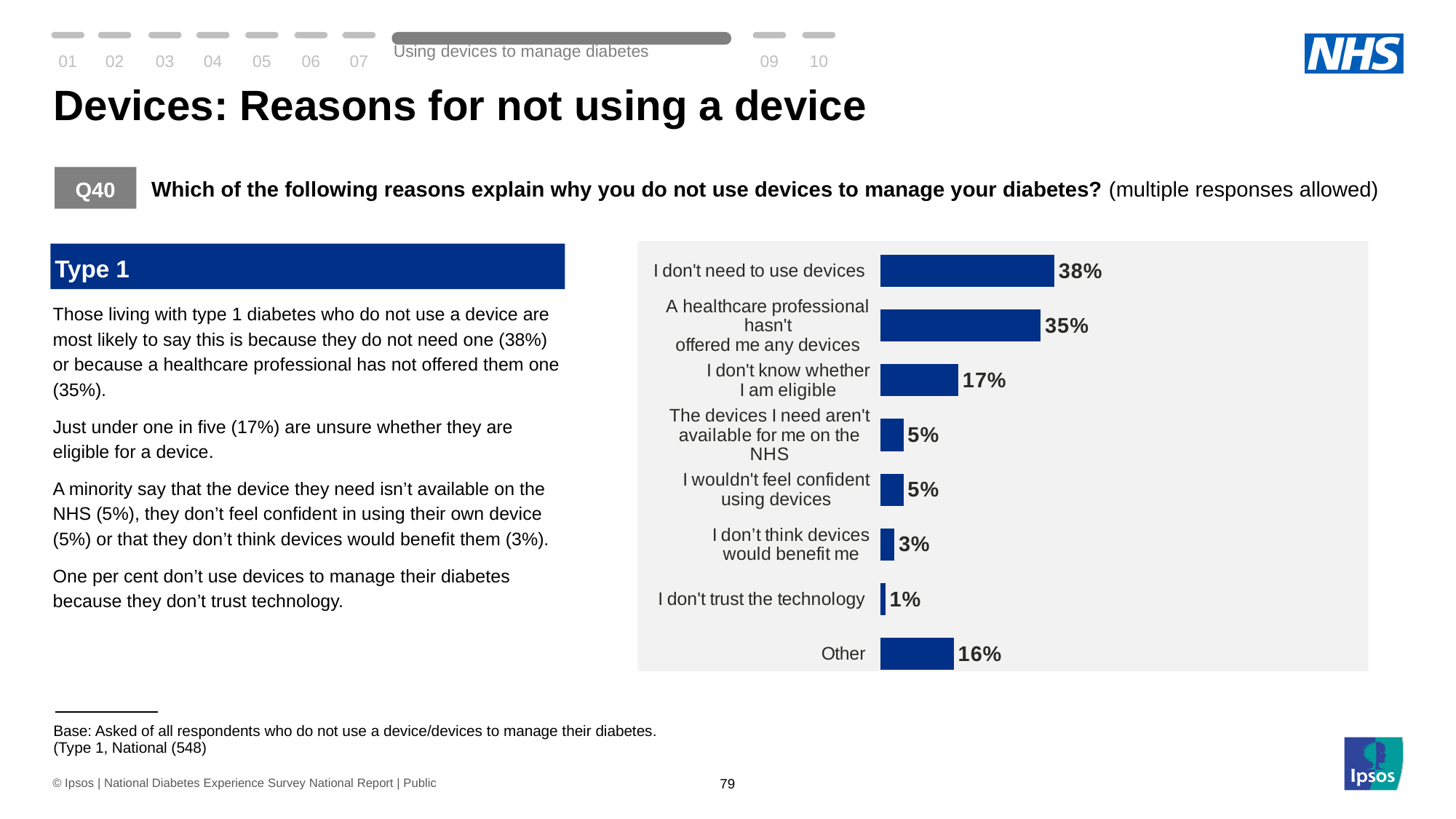
Which reason has the lowest percentage? I don't trust the technology What percentage said a healthcare professional hasn't offered them any devices? 35% Which diabetes type does the chart on this slide cover? Type 1 Which reason has the highest percentage? I don't need to use devices What is the value for the "Other" category? 16% What percentage said "I don't know whether I am eligible"? 17% What percentage of respondents said "I don't need to use devices"? 38% How many reason categories are shown in the chart? 8 Which is larger: "I don't know whether I am eligible" or "Other"? I don't know whether I am eligible What type of chart is shown on the slide? Bar chart What is the difference between "I don't need to use devices" and "A healthcare professional hasn't offered me any devices"? 3 percentage points What percentage said "I don't trust the technology"? 1%